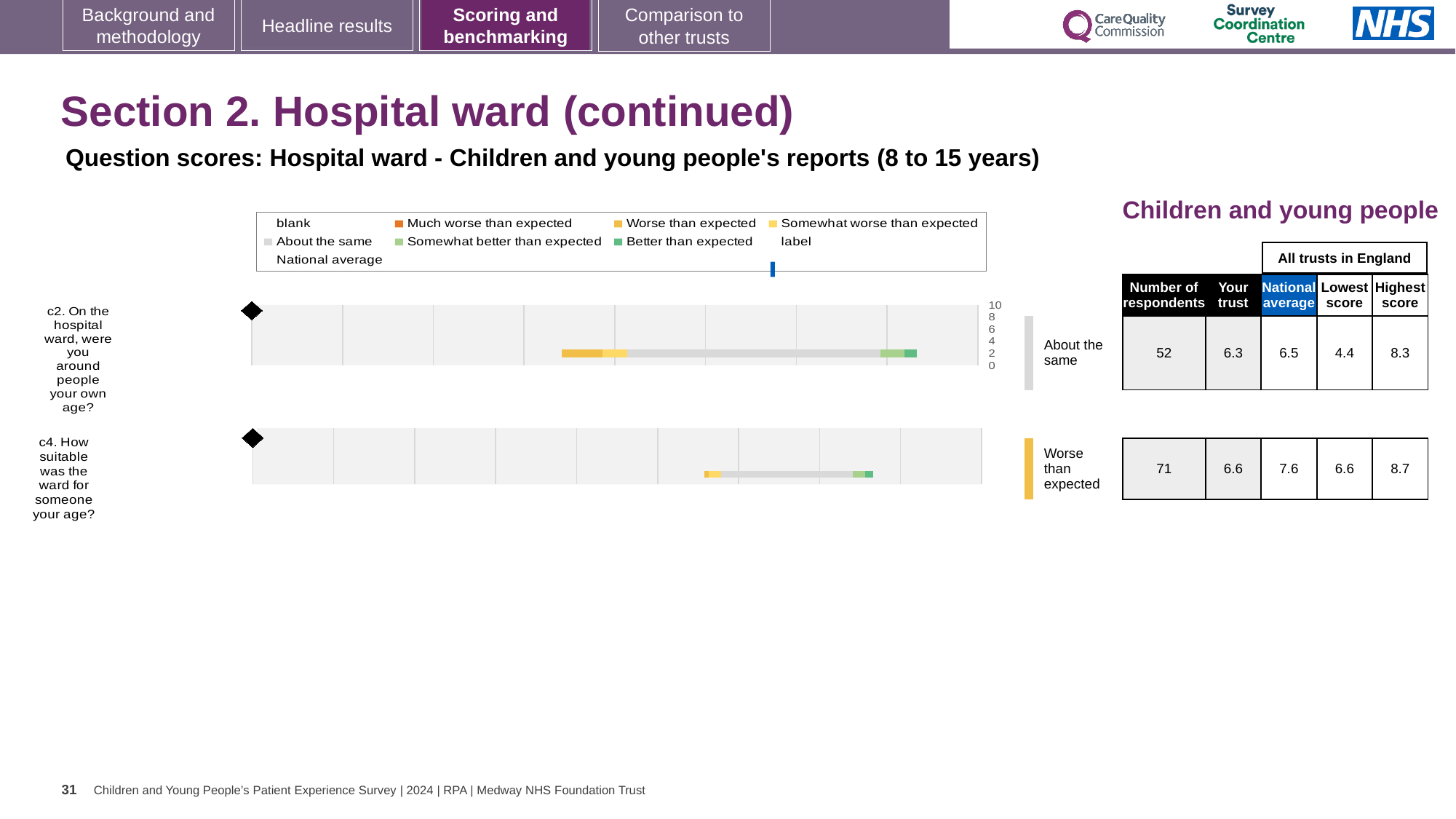
What kind of chart is used to show the question scores on this slide? bar chart How many respondents answered question c2? 52 What is the difference between the highest and lowest scores across all trusts for question c2? 3.9 What is the 'Your trust' score for question c2 (On the hospital ward, were you around people your own age?)? 6.3 What benchmark rating is shown for question c4? Worse than expected What is the national average score for question c4 (How suitable was the ward for someone your age?)? 7.6 What benchmark rating is shown for question c2? About the same Which question has the higher 'Your trust' score, c2 or c4? c4 How many questions are plotted in the chart on this slide? 2 For question c4, how much higher is the national average than the trust's score? 1.0 Which question has more respondents, c2 or c4? c4 What is the highest score across all trusts in England for question c4? 8.7